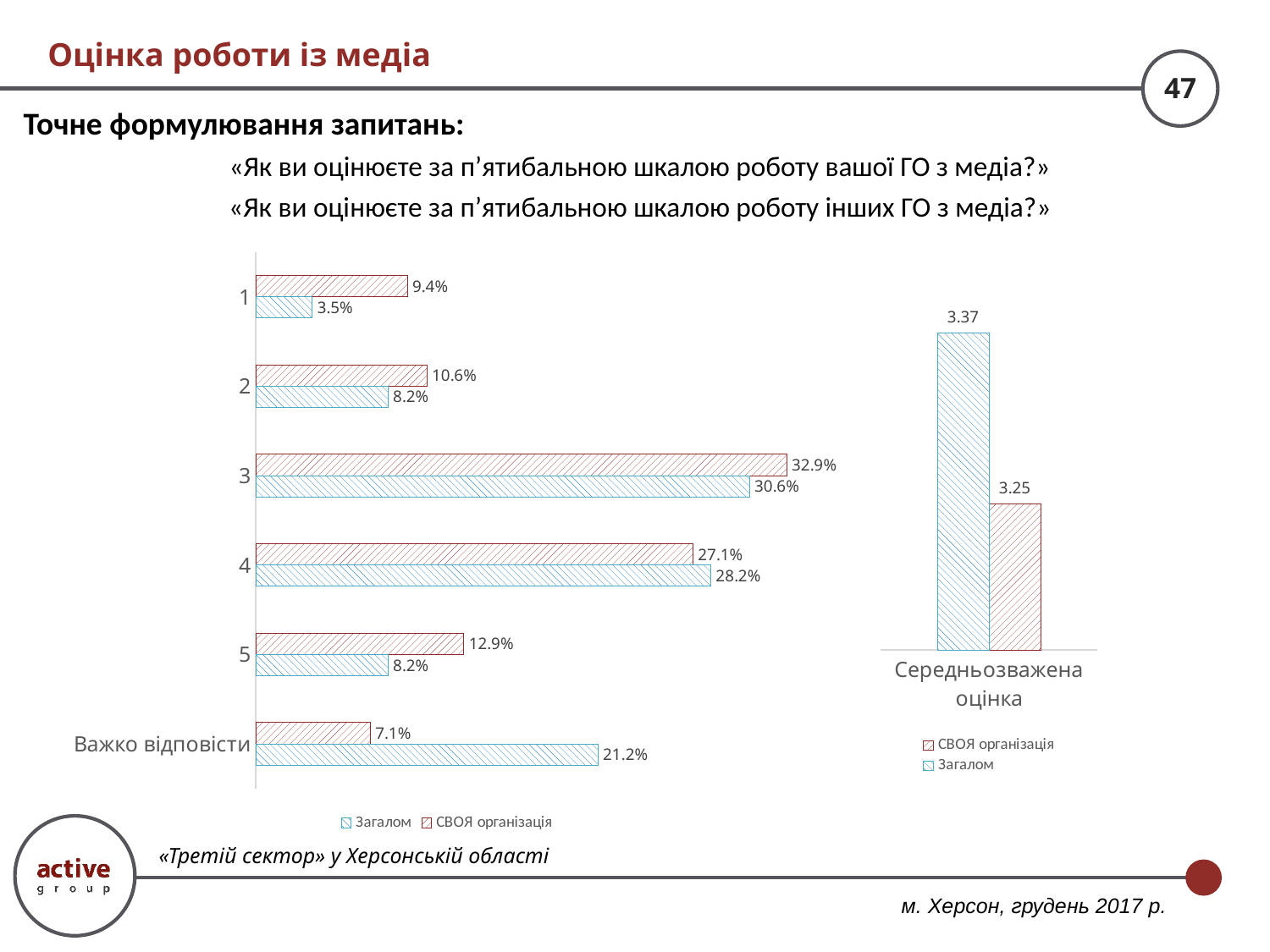
In the left chart, what is the value for 'Загалом' for 'Важко відповісти'? 21.2% In the left chart, what is the value for 'СВОЯ організація' for category 3? 32.9% In the left chart, what is the difference between 'Загалом' and 'СВОЯ організація' for 'Важко відповісти'? 14.1% In the right chart 'Середньозважена оцінка', what is the difference between 'Загалом' and 'СВОЯ організація'? 0.12 What kind of chart is the left chart? bar chart In the left chart, for category 4, which series has the larger value: 'Загалом' or 'СВОЯ організація'? Загалом In the right chart 'Середньозважена оцінка', what is the value for 'Загалом'? 3.37 How many series does the legend of the left chart list? 2 In the left chart, what is the value for 'Загалом' for category 1? 3.5% How many categories are shown on the left chart? 6 In the left chart, which category has the highest value for 'Загалом'? 3 In the left chart, which category has the lowest value for 'СВОЯ організація'? Важко відповісти